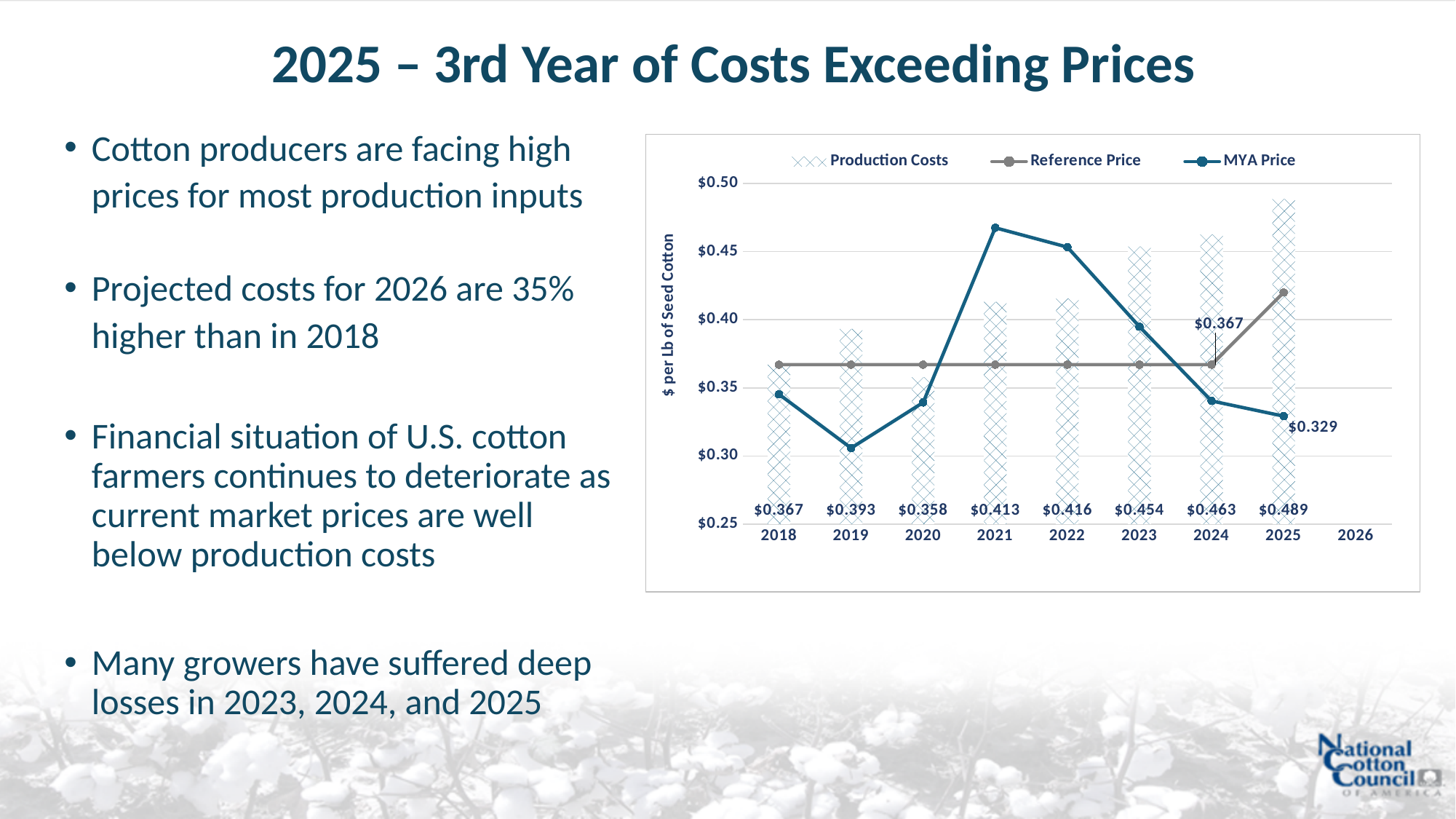
How many series does the legend list? 3 What is the difference between the Production Costs values for 2025 and 2018? $0.122 Is the MYA Price value for 2021 greater or less than $0.45? greater Which year has the highest Production Costs value? 2025 What is the Production Costs value for 2025? $0.489 Which is larger, the Production Costs value for 2019 or for 2020? 2019 What is the label on the vertical axis? $ per Lb of Seed Cotton What is the Reference Price value labeled for 2024? $0.367 How many years have a labeled Production Costs value? 8 What is the Production Costs value for 2020? $0.358 Which year has the lowest Production Costs value? 2020 What is the MYA Price value labeled for 2025? $0.329